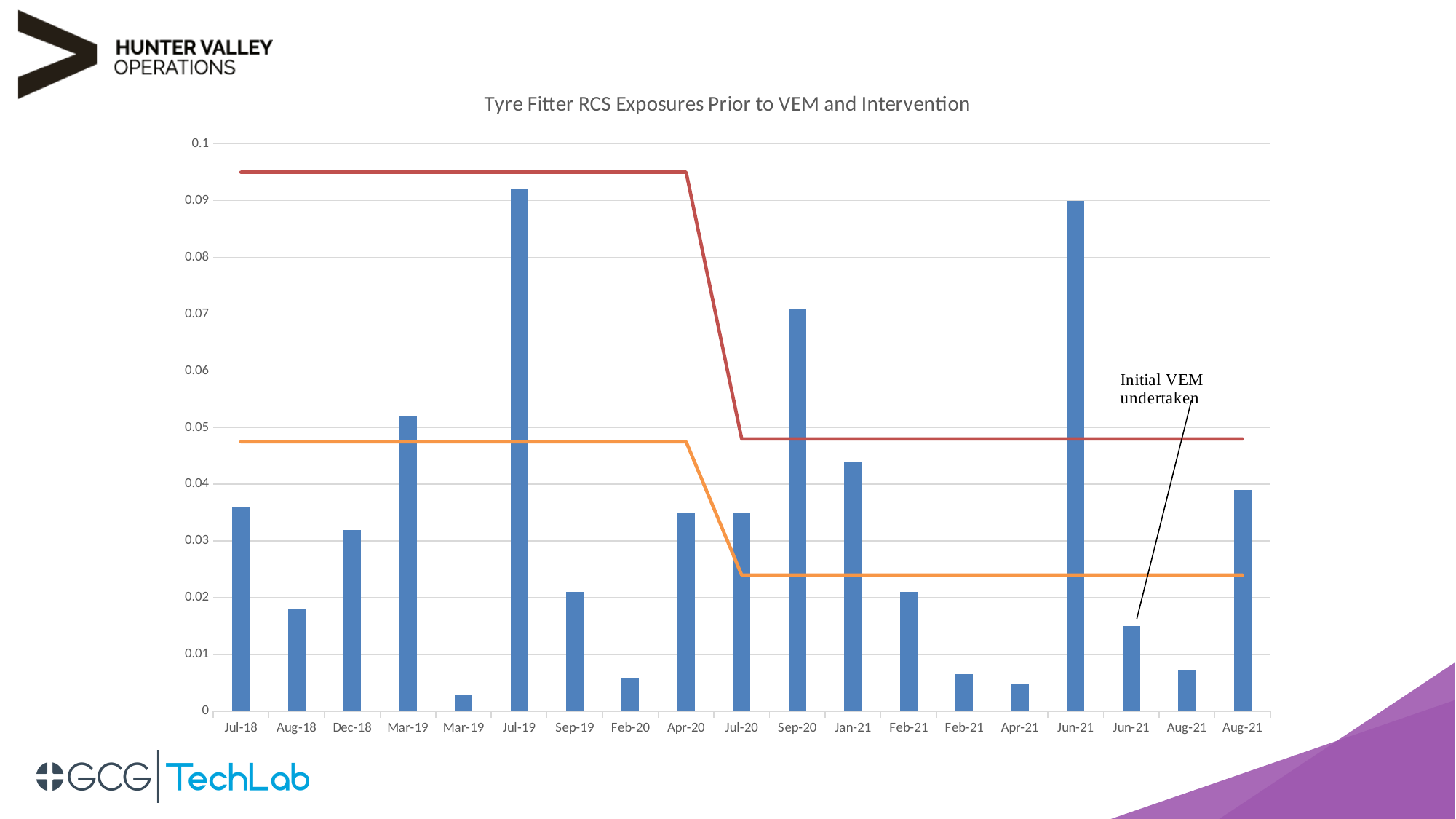
Is the value for Aug-18 greater or less than 0.03? less Is the value for Apr-21 greater or less than 0.01? less What is the title of the chart? Tyre Fitter RCS Exposures Prior to VEM and Intervention Which is larger, the value for Jul-19 or the value for Sep-19? Jul-19 Is the value for Sep-20 greater or less than 0.06? greater How many bars are plotted on the chart? 19 What does the text annotation pointing to the second Jun-21 bar say? Initial VEM undertaken What kind of chart is used to show the exposure values? Bar chart